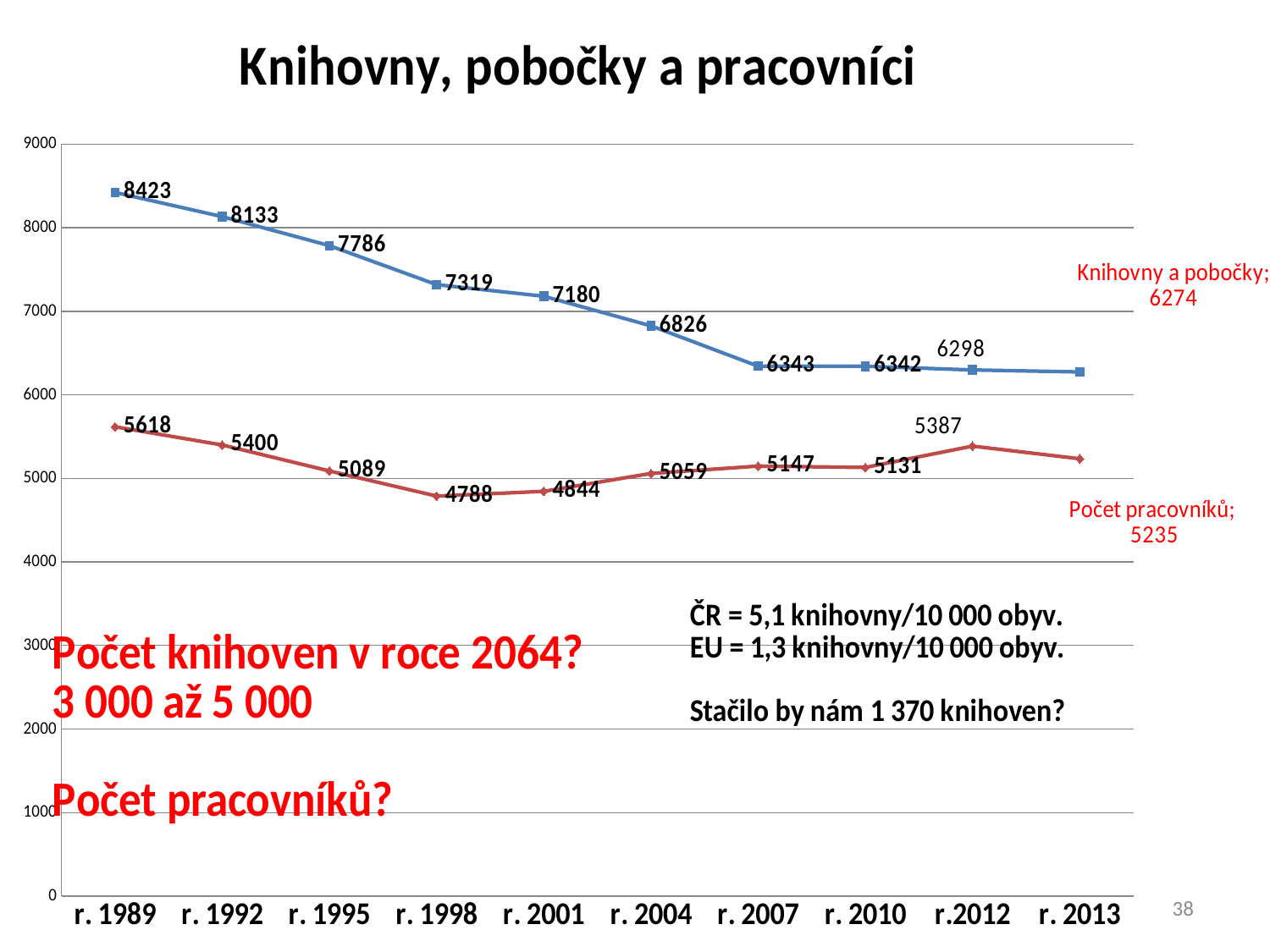
What is the difference between Knihovny a pobočky in r. 1989 and in r. 2013? 2149 Does the Knihovny a pobočky series rise or fall from r. 1989 to r. 2013? fall What type of chart is shown on the slide? line chart What is the value of Počet pracovníků in r.2012? 5387 Which is larger: Počet pracovníků in r. 1989 or in r. 2013? r. 1989 What is the value of Knihovny a pobočky in r. 2013? 6274 How many years are shown on the x axis? 10 In which year is Počet pracovníků lowest? r. 1998 What is the value of Počet pracovníků in r. 1998? 4788 How many data series are plotted on the chart? 2 What is the value of Knihovny a pobočky in r. 1989? 8423 In which year is Knihovny a pobočky highest? r. 1989